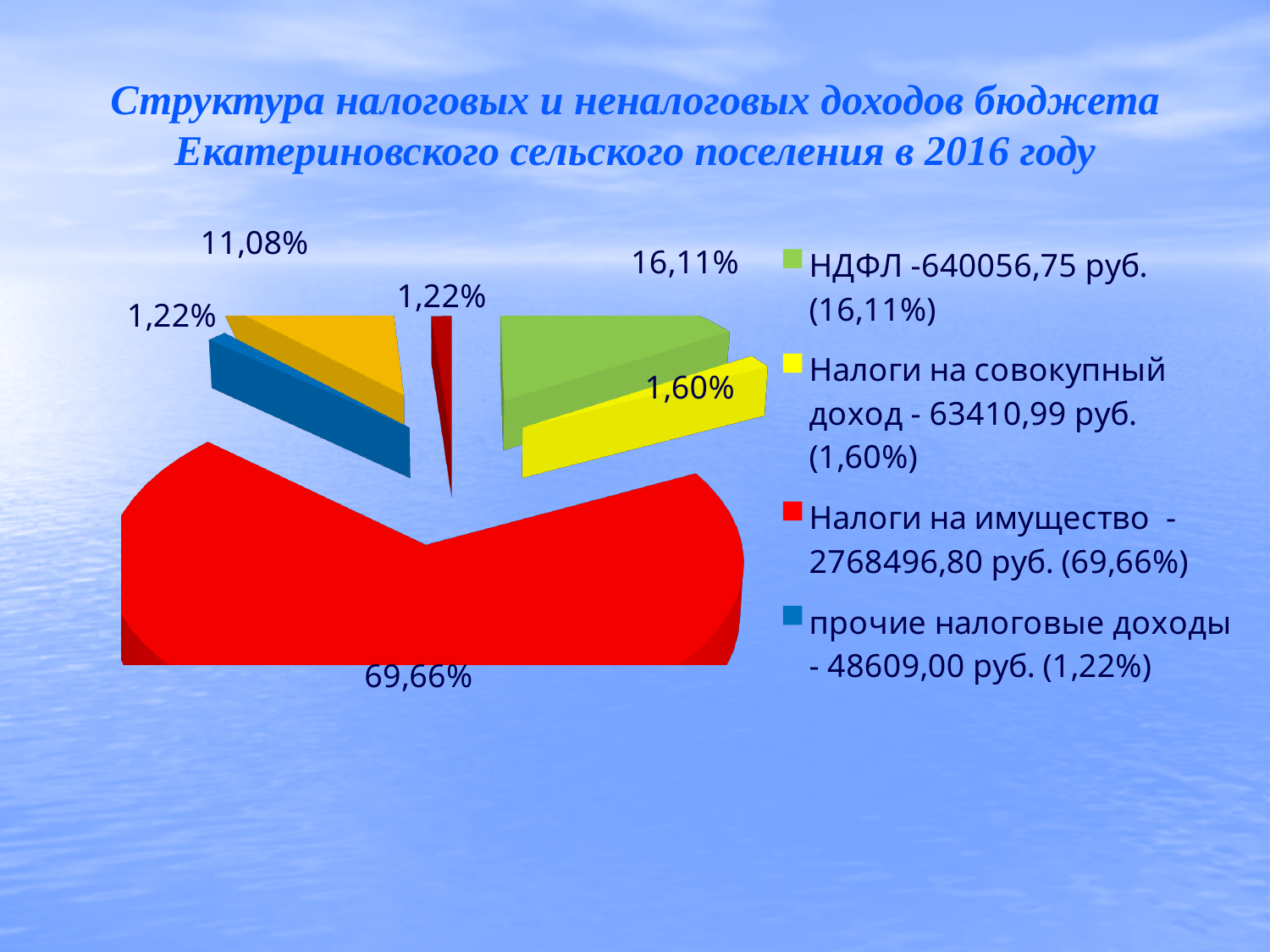
Which category has the largest slice of the pie? Налоги на имущество According to the legend, what is the ruble amount for НДФЛ? 640056,75 руб. What is the difference in percentage points between the share for Налоги на имущество and the share for НДФЛ? 53,55% What share of the pie does Налоги на имущество account for? 69,66% What share of the pie does Налоги на совокупный доход account for? 1,60% What share of the pie does НДФЛ account for? 16,11% Which is larger: the share for НДФЛ or the share for Налоги на совокупный доход? НДФЛ How many slices does the pie chart have? 6 What kind of chart is shown on the slide? pie chart How many entries does the legend list? 4 What colour is the slice for Налоги на имущество? red